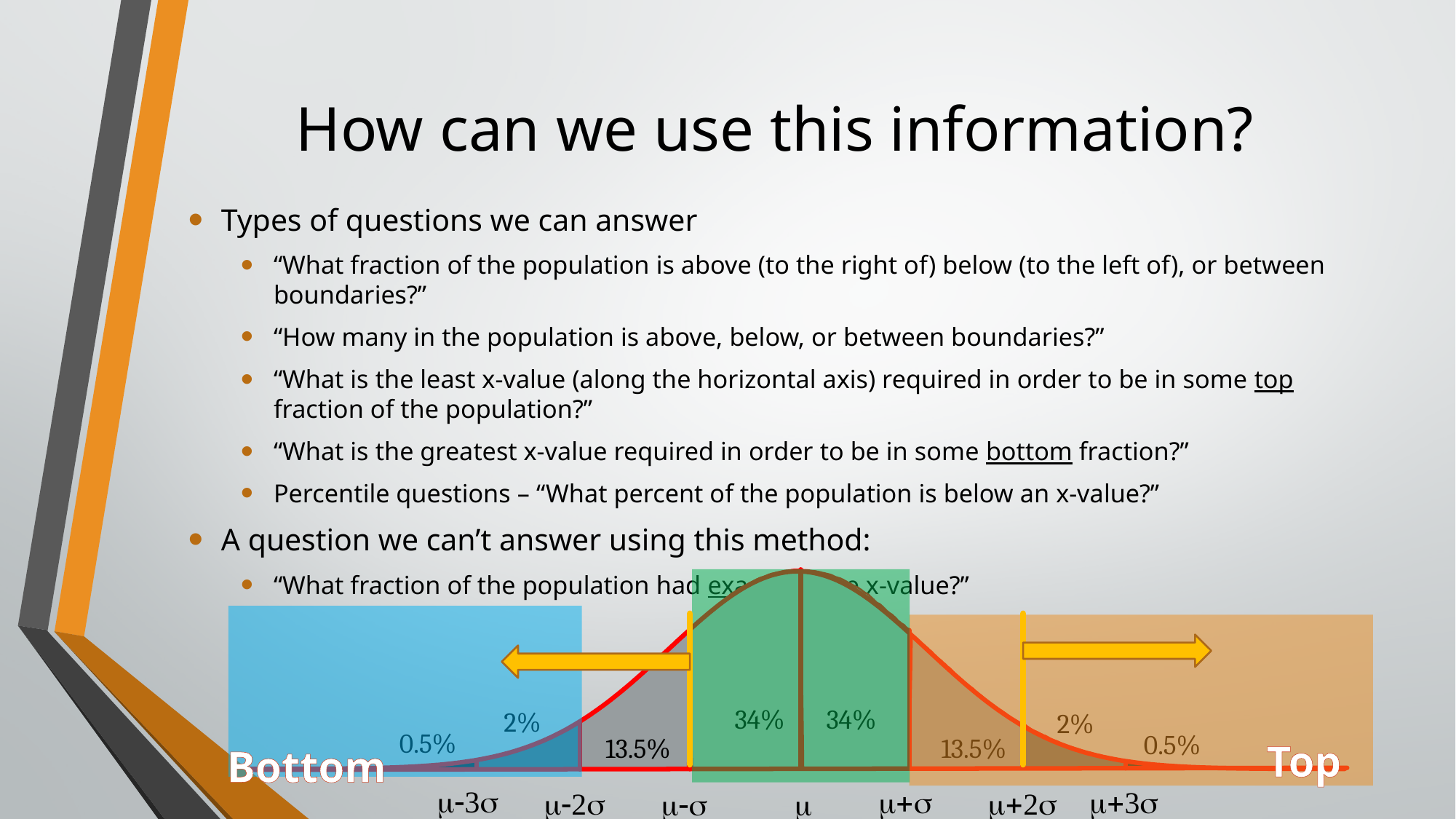
What kind of chart is shown at the bottom of the slide? A normal distribution (bell) curve What is the difference between the 34% region and the 13.5% region? 20.5% How many labeled tick positions are shown along the horizontal axis of the curve? 7 What is the smallest percentage labeled on the curve? 0.5% What percentage of the population lies between μ and μ+σ on the normal curve? 34% What percentage of the population lies between μ-2σ and μ-σ on the normal curve? 13.5% What is the total percentage of the population between μ-σ and μ+σ? 68% What percentage is labeled beyond μ+3σ at the far right of the curve? 0.5% Is the 13.5% region larger or smaller than the 2% region? larger What percentage of the population lies between μ+2σ and μ+3σ on the normal curve? 2% What is the total percentage of the population between μ-2σ and μ+2σ? 95% Which interval on the curve has the largest labeled percentage? μ to μ+σ (and μ-σ to μ, each 34%)